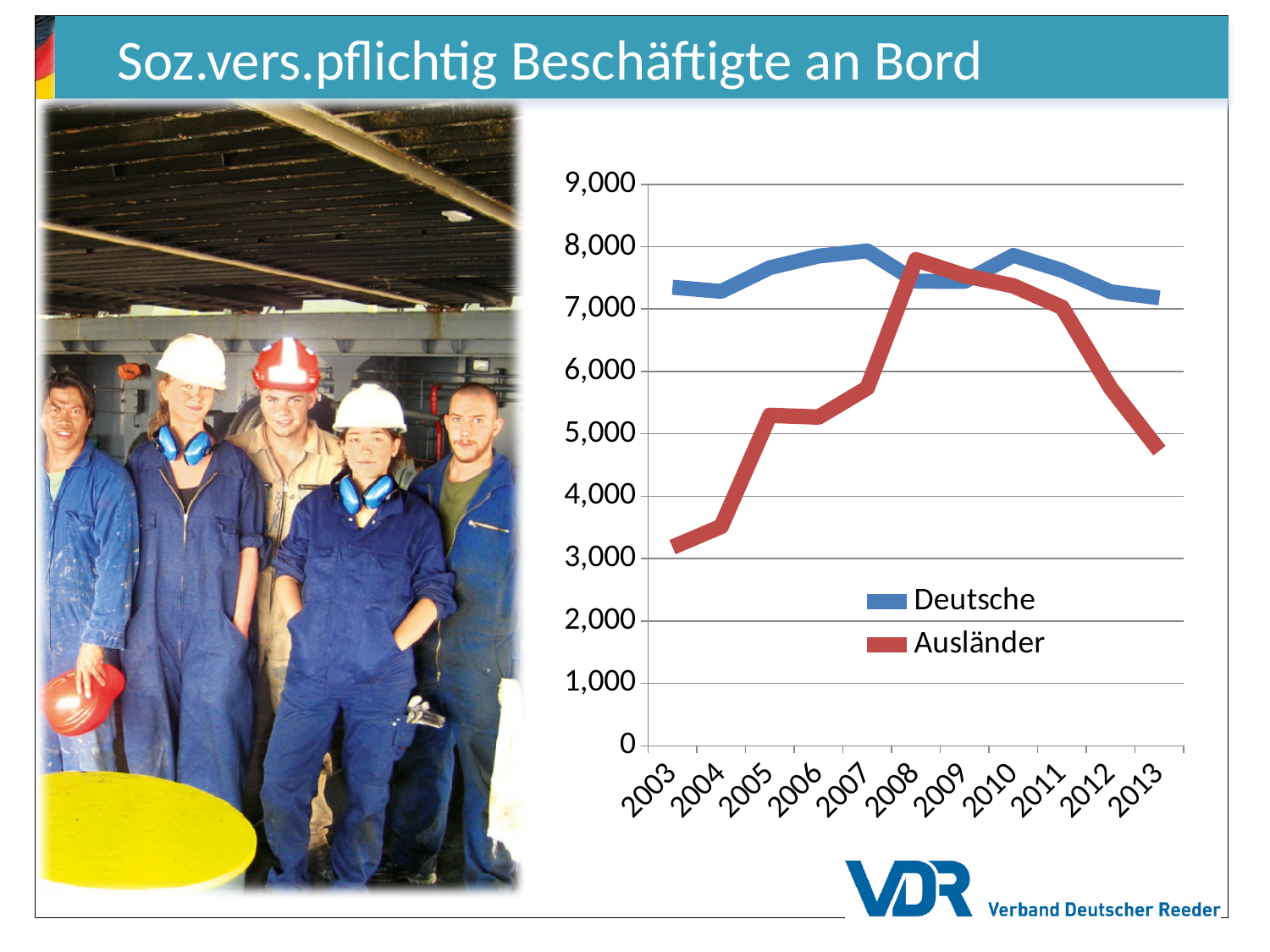
Does the Ausländer series rise or fall from 2008 to 2013? fall What kind of chart is shown on the slide? line chart Which series is drawn in red? Ausländer How many series does the legend list? 2 How many years are shown on the x axis? 11 In which year does the Ausländer series reach its highest value? 2008 Is the value for Ausländer in 2008 greater or less than 7,000? greater Is the value for Deutsche in 2007 greater or less than 7,000? greater Is the value for Ausländer in 2013 greater or less than 5,000? less In 2003, which series has the higher value, Deutsche or Ausländer? Deutsche In 2008, which series has the higher value, Deutsche or Ausländer? Ausländer